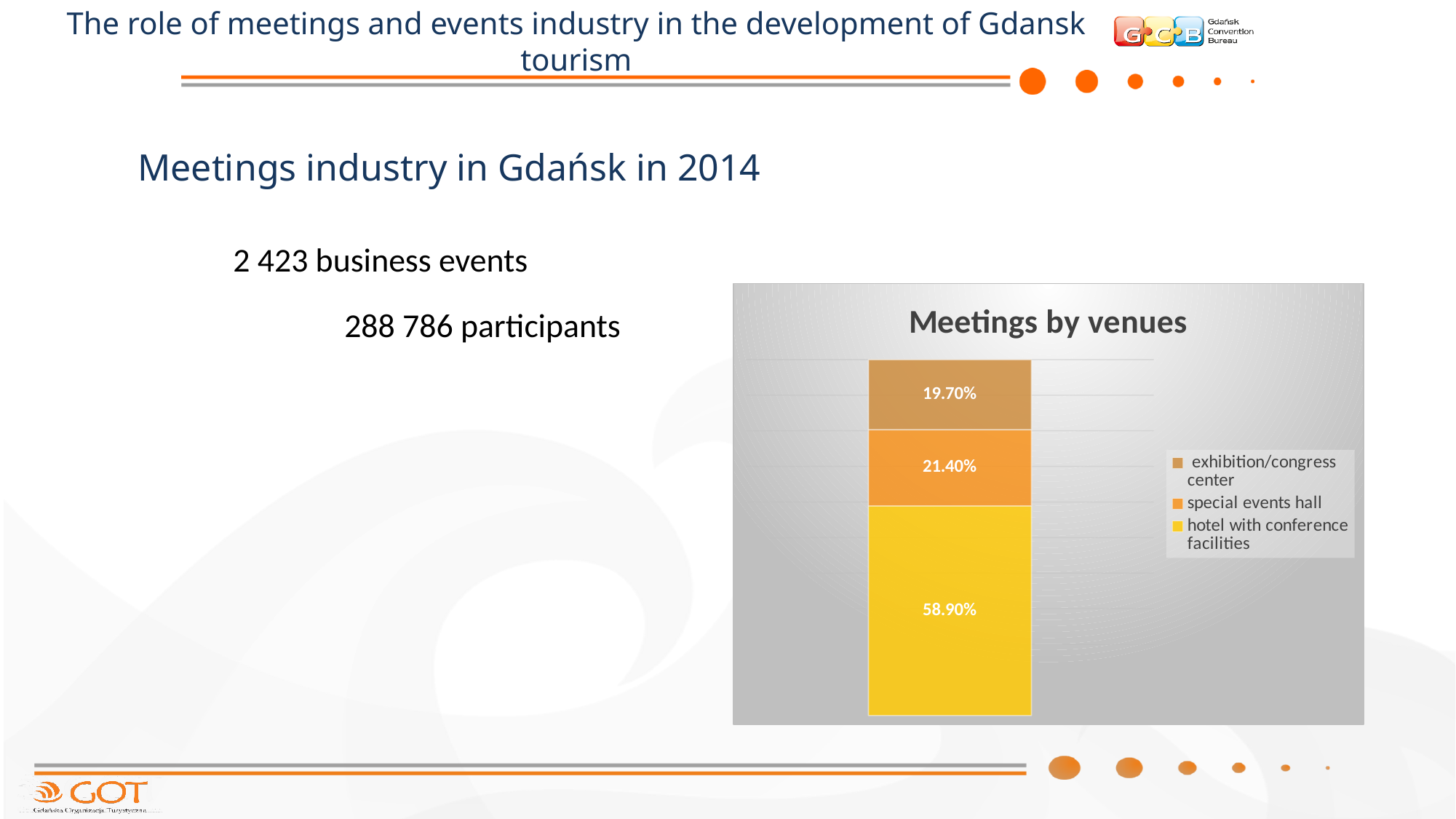
Which venue type accounts for the largest share of meetings? hotel with conference facilities Which venue type accounts for the smallest share of meetings? exhibition/congress center What is the title of the chart? Meetings by venues What share of meetings were held in hotels with conference facilities? 58.90% What share of meetings were held in special events halls? 21.40% Which has a larger share of meetings: special events hall or exhibition/congress center? special events hall What share of meetings were held in exhibition/congress centers? 19.70% How many venue types does the legend list? 3 What is the difference between the share for hotels with conference facilities and the share for special events halls? 37.50% What is the total of the three segments in the stacked bar? 100.00% What is the difference between the share for special events halls and the share for exhibition/congress centers? 1.70% What type of chart is used to show meetings by venues? stacked bar chart